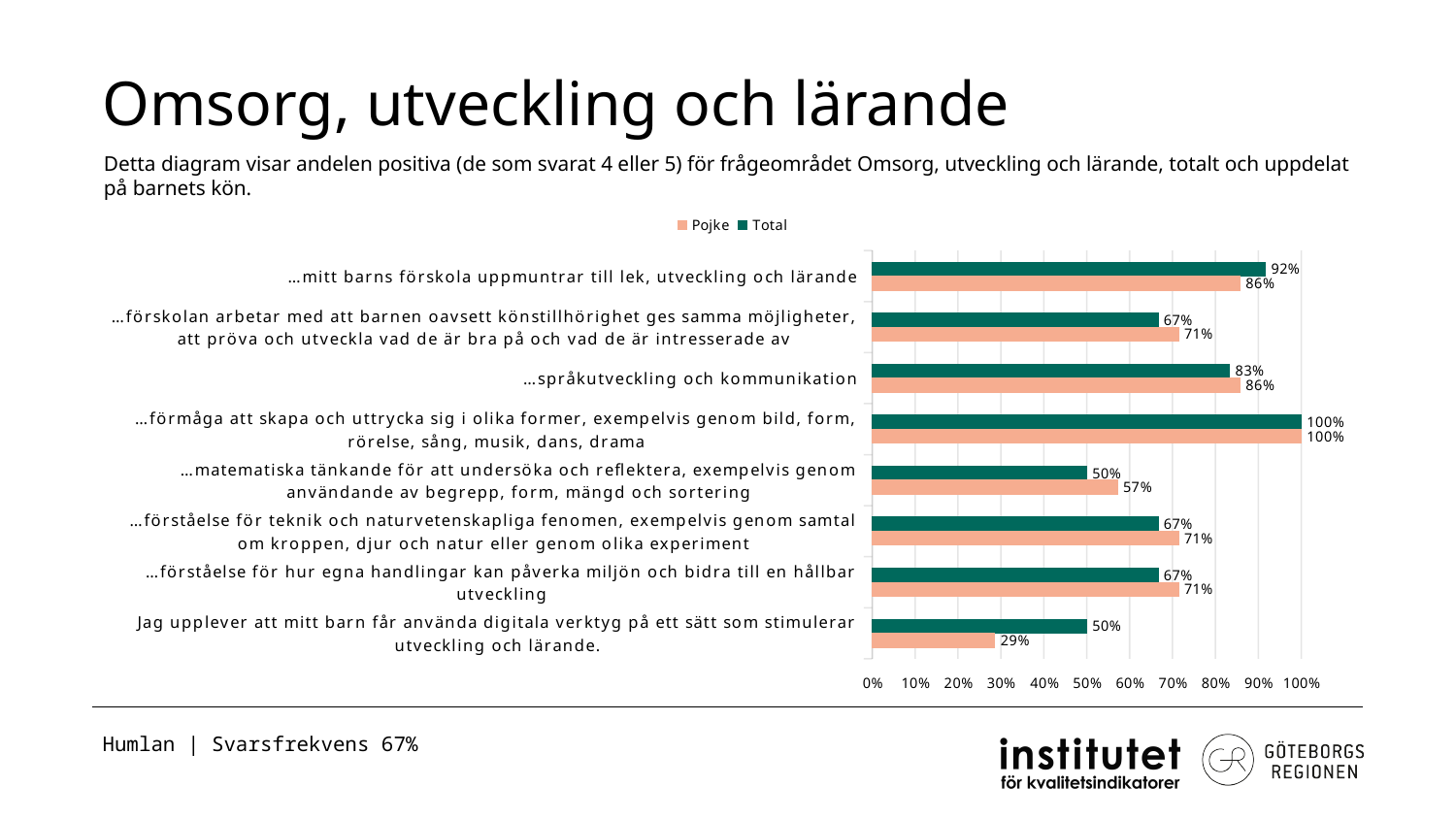
What is the Total value for "…mitt barns förskola uppmuntrar till lek, utveckling och lärande"? 92% What is the Pojke value for "Jag upplever att mitt barn får använda digitala verktyg på ett sätt som stimulerar utveckling och lärande."? 29% Which category has the highest Total value? …förmåga att skapa och uttrycka sig i olika former, exempelvis genom bild, form, rörelse, sång, musik, dans, drama For "…språkutveckling och kommunikation", which is larger: the Pojke value or the Total value? Pojke How many series does the legend list? 2 Which category has the lowest Pojke value? Jag upplever att mitt barn får använda digitala verktyg på ett sätt som stimulerar utveckling och lärande. What is the difference between the Total and Pojke values for "Jag upplever att mitt barn får använda digitala verktyg på ett sätt som stimulerar utveckling och lärande."? 21% Which series is shown in dark green in the legend? Total How many categories (statements) are plotted in the chart? 8 What is the Pojke value for "…matematiska tänkande för att undersöka och reflektera, exempelvis genom användande av begrepp, form, mängd och sortering"? 57% What kind of chart is shown on the slide? Bar chart What is the difference between the Total and Pojke values for "…mitt barns förskola uppmuntrar till lek, utveckling och lärande"? 6%